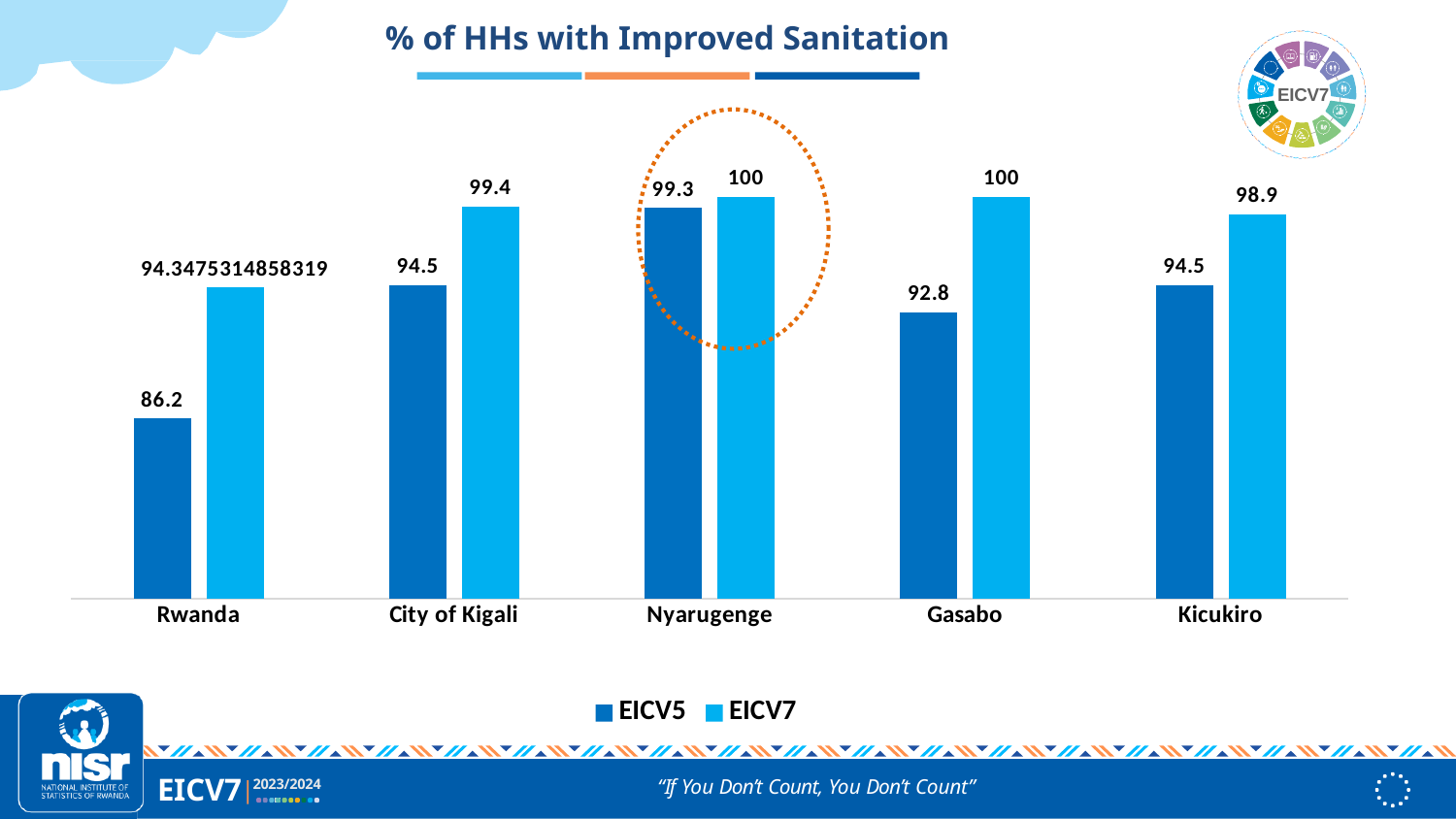
How many series does the legend list? 2 What is the EICV7 value for Rwanda as printed on the slide? 94.3475314858319 Which category has the lowest EICV5 value? Rwanda What is the EICV5 value for Rwanda? 86.2 What is the EICV5 value for Gasabo? 92.8 What is the EICV7 value for Kicukiro? 98.9 What kind of chart is shown on the slide? Bar chart Which category has the highest EICV5 value? Nyarugenge Which is larger, the EICV5 value for Nyarugenge or the EICV5 value for Kicukiro? Nyarugenge What is the difference between the EICV7 and EICV5 values for Gasabo? 7.2 What is the EICV7 value for City of Kigali? 99.4 How many categories are shown on the x axis? 5